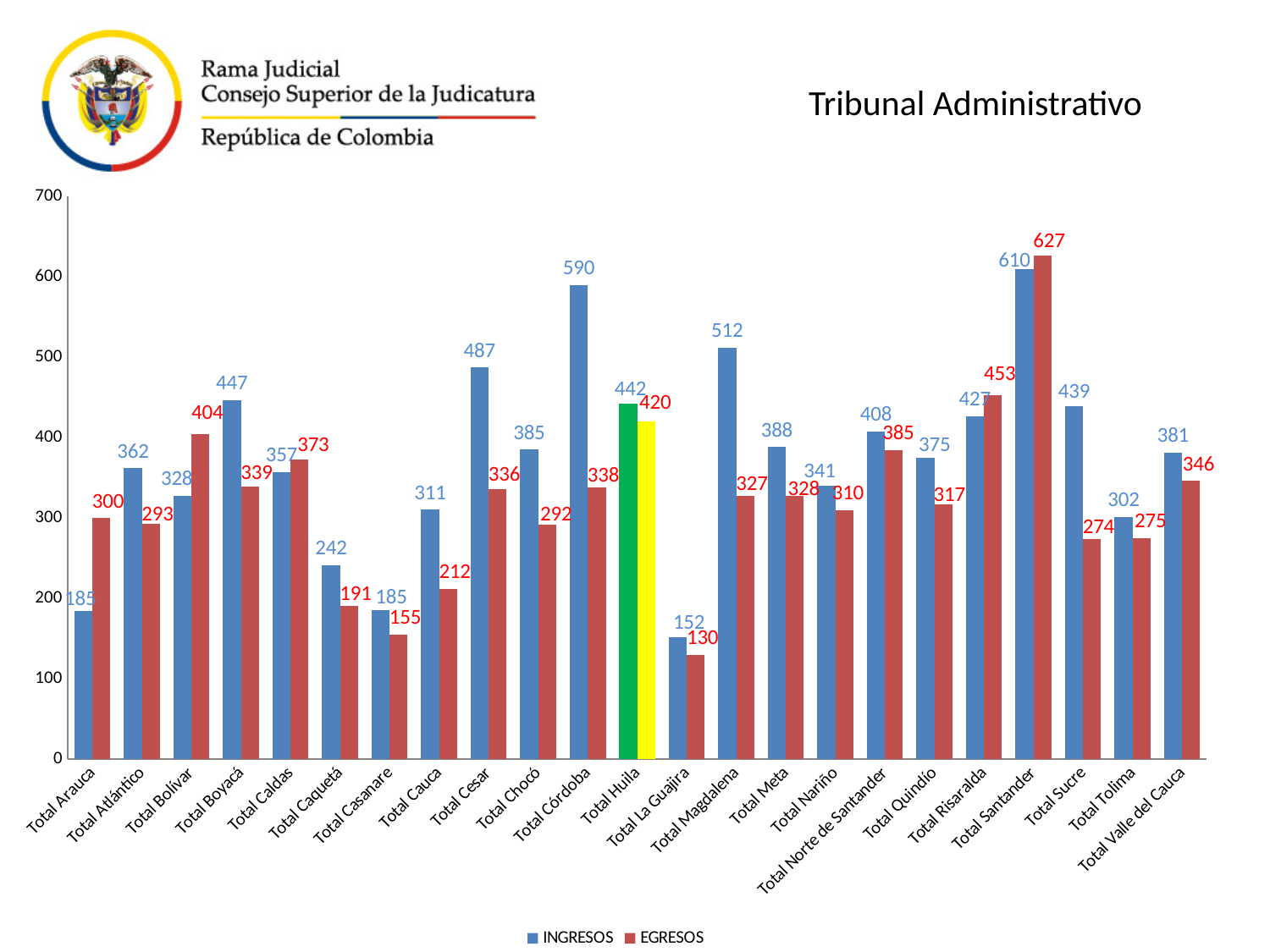
How many series does the legend list? 2 What kind of chart is shown on the slide? Bar chart Which is larger for Total Boyacá, INGRESOS or EGRESOS? INGRESOS What is the INGRESOS value for Total Córdoba? 590 What is the difference between INGRESOS and EGRESOS for Total Huila? 22 How many categories are shown on the x axis? 23 What is the EGRESOS value for Total Bolívar? 404 Which category has the lowest EGRESOS value? Total La Guajira What is the difference between INGRESOS and EGRESOS for Total Santander? 17 Which category has the highest INGRESOS value? Total Santander Which category's bars are coloured green and yellow instead of blue and red? Total Huila Is the INGRESOS value for Total Magdalena greater or less than 500? greater